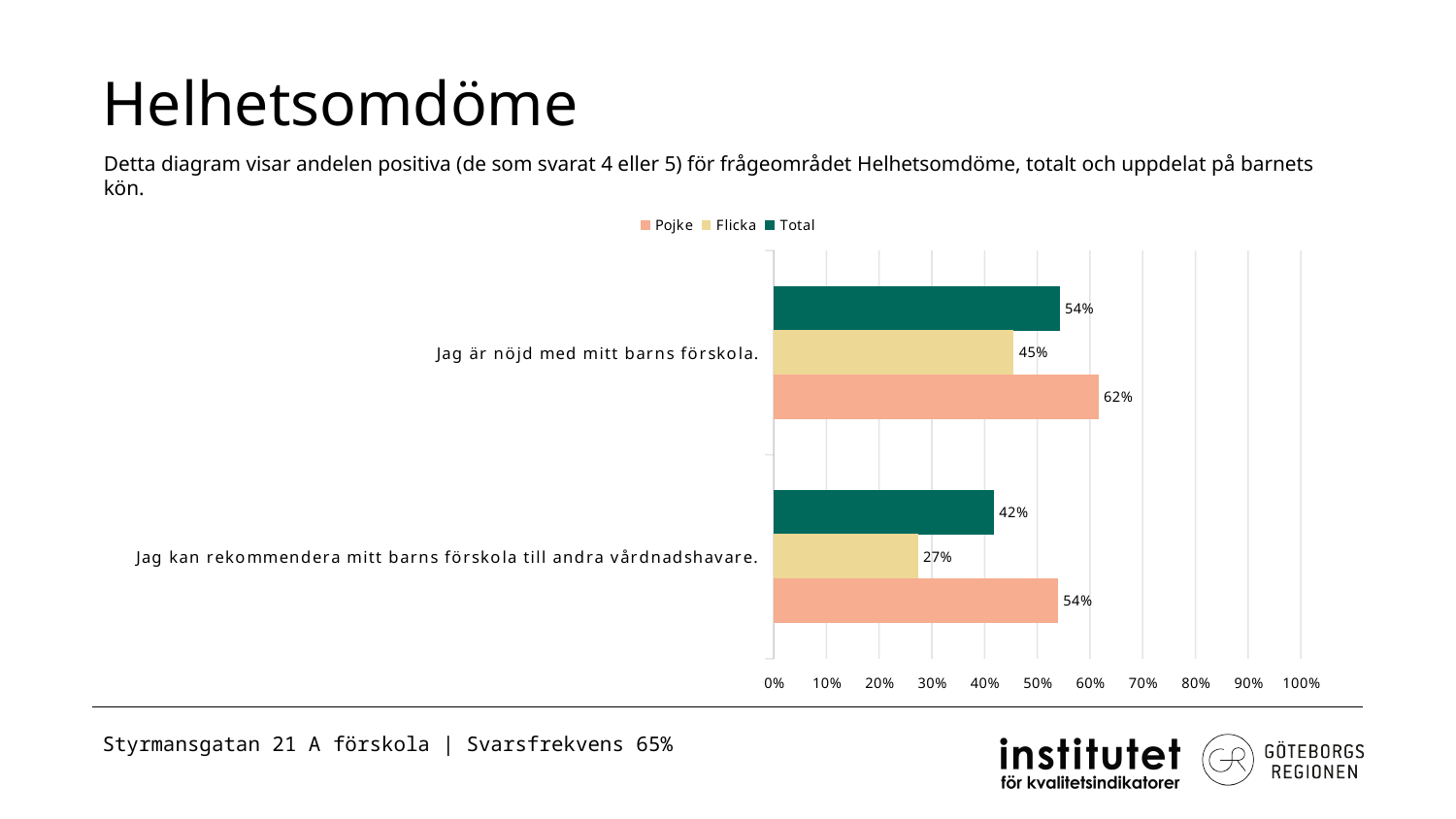
Which series has the lowest value for "Jag är nöjd med mitt barns förskola."? Flicka What is the difference between the Pojke and Flicka values for "Jag är nöjd med mitt barns förskola."? 17% How many categories are shown on the chart? 2 What is the Pojke value for "Jag är nöjd med mitt barns förskola."? 62% What kind of chart is shown on the slide? Bar chart Which is larger: the Flicka value for "Jag är nöjd med mitt barns förskola." or the Flicka value for "Jag kan rekommendera mitt barns förskola till andra vårdnadshavare."? Jag är nöjd med mitt barns förskola. What is the Total value for "Jag kan rekommendera mitt barns förskola till andra vårdnadshavare."? 42% How many series does the legend list? 3 What is the Total value for "Jag är nöjd med mitt barns förskola."? 54% What is the Flicka value for "Jag kan rekommendera mitt barns förskola till andra vårdnadshavare."? 27% Which series has the highest value for "Jag kan rekommendera mitt barns förskola till andra vårdnadshavare."? Pojke What is the difference between the Pojke and Flicka values for "Jag kan rekommendera mitt barns förskola till andra vårdnadshavare."? 27%